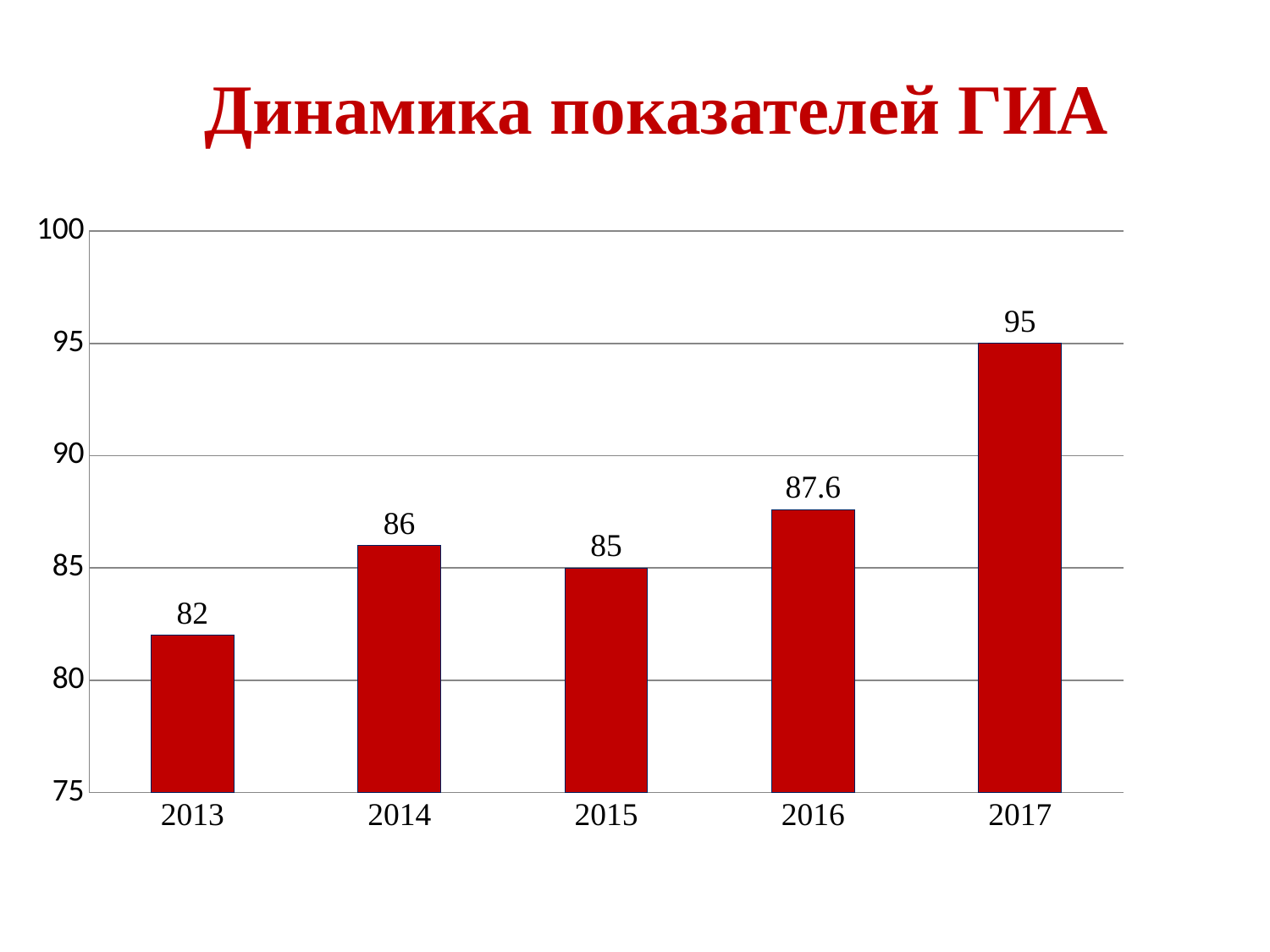
What is the value for 2016? 87.6 What is the difference between the values for 2016 and 2015? 2.6 Is the value for 2016 greater or less than 90? less What is the value for 2013? 82 What is the title of the chart? Динамика показателей ГИА Which year has the highest value? 2017 Which year has the lowest value? 2013 Which is larger, the value for 2014 or the value for 2015? 2014 What kind of chart is shown on the slide? bar chart What is the difference between the values for 2017 and 2013? 13 What is the value for 2015? 85 How many years are shown on the x axis? 5